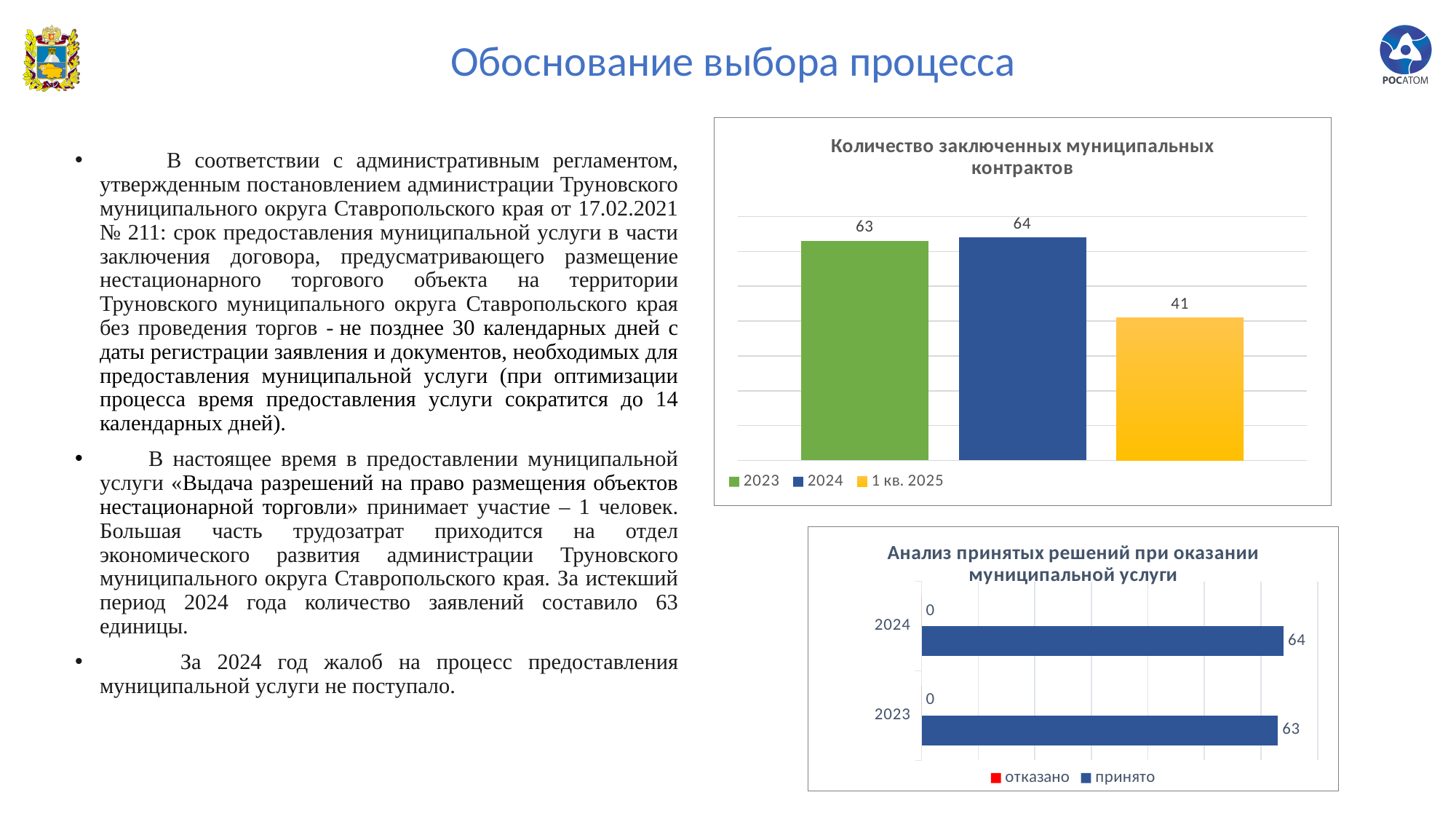
In the chart 'Количество заключенных муниципальных контрактов', what is the difference between the values for 2024 and 1 кв. 2025? 23 In the chart 'Количество заключенных муниципальных контрактов', how many categories are shown? 3 In the chart 'Анализ принятых решений при оказании муниципальной услуги', what is the value of 'отказано' for 2023? 0 In the chart 'Анализ принятых решений при оказании муниципальной услуги', what is the value of 'принято' for 2024? 64 In the chart 'Количество заключенных муниципальных контрактов', what is the value for 1 кв. 2025? 41 In the chart 'Количество заключенных муниципальных контрактов', what colour is the bar for 1 кв. 2025? Yellow What kind of chart is 'Количество заключенных муниципальных контрактов'? Bar chart In the chart 'Количество заключенных муниципальных контрактов', what is the value for 2023? 63 In the chart 'Количество заключенных муниципальных контрактов', which category has the highest value? 2024 In the chart 'Количество заключенных муниципальных контрактов', which category has the lowest value? 1 кв. 2025 In the chart 'Анализ принятых решений при оказании муниципальной услуги', how many series does the legend list? 2 In the chart 'Анализ принятых решений при оказании муниципальной услуги', which is larger: 'принято' for 2024 or 'принято' for 2023? 2024